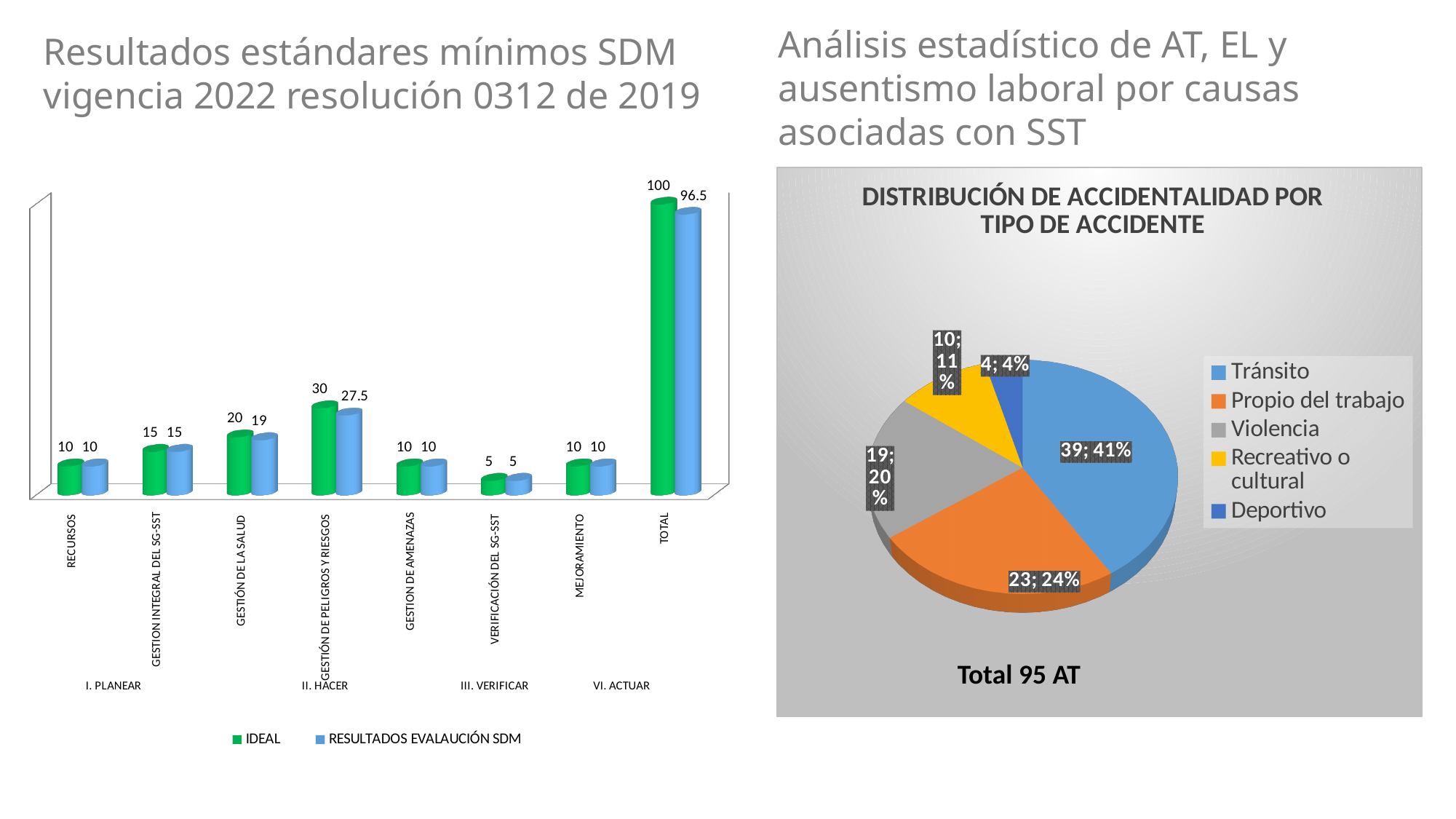
In the bar chart on the left, what is the IDEAL value for GESTIÓN DE LA SALUD? 20 What type of chart is shown on the right side of the slide? Pie chart In the pie chart titled DISTRIBUCIÓN DE ACCIDENTALIDAD POR TIPO DE ACCIDENTE, which category has the largest slice? Tránsito In the bar chart on the left, what is the difference between the IDEAL and RESULTADOS EVALAUCIÓN SDM values for TOTAL? 3.5 In the bar chart on the left, which category has the lowest IDEAL value? VERIFICACIÓN DEL SG-SST In the bar chart on the left, how many categories are shown on the x axis? 8 In the pie chart titled DISTRIBUCIÓN DE ACCIDENTALIDAD POR TIPO DE ACCIDENTE, what is the value for Propio del trabajo? 23; 24% In the pie chart titled DISTRIBUCIÓN DE ACCIDENTALIDAD POR TIPO DE ACCIDENTE, which is larger, Recreativo o cultural or Deportivo? Recreativo o cultural In the bar chart on the left, what is the RESULTADOS EVALAUCIÓN SDM value for GESTIÓN DE PELIGROS Y RIESGOS? 27.5 In the bar chart on the left, what is the RESULTADOS EVALAUCIÓN SDM value for TOTAL? 96.5 In the bar chart on the left, how many series does the legend list? 2 In the pie chart titled DISTRIBUCIÓN DE ACCIDENTALIDAD POR TIPO DE ACCIDENTE, what share of the pie does Violencia represent? 20%